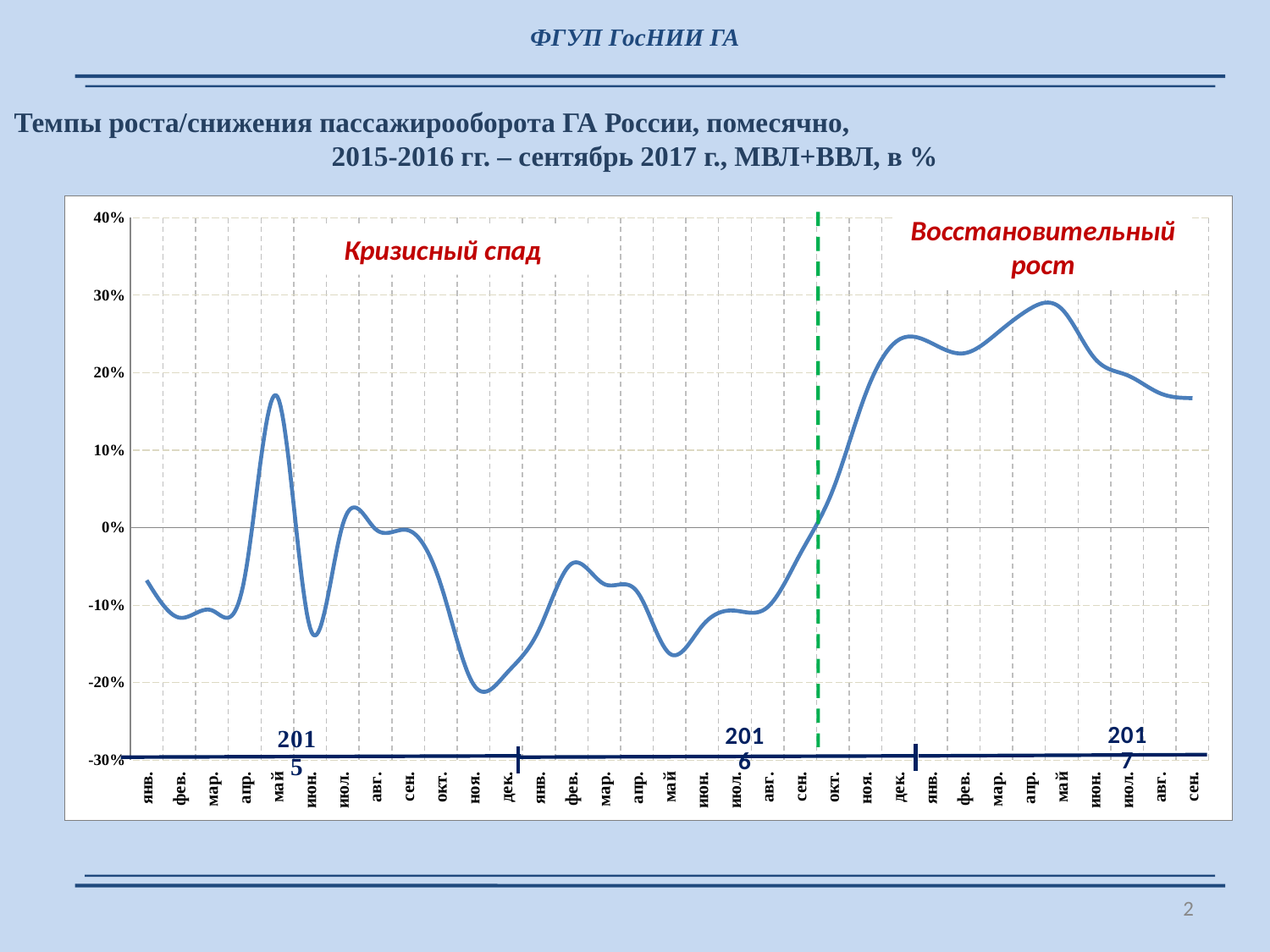
Is the value for сен. 2017 greater or less than 10%? greater Is the value for сен. 2016 greater or less than 0%? less In which month is the plotted value lowest? ноя. 2015 Is the value for май 2015 greater or less than 10%? greater What kind of chart is shown on the slide? line chart What label is written in red on the right-hand part of the chart, after the green dashed line? Восстановительный рост How many monthly points are plotted on the chart (January 2015 through September 2017)? 33 Do the values rise or fall from май 2017 to сен. 2017? fall Which is larger, the value for май 2015 or the value for май 2017? май 2017 In which month is the plotted value highest? май 2017